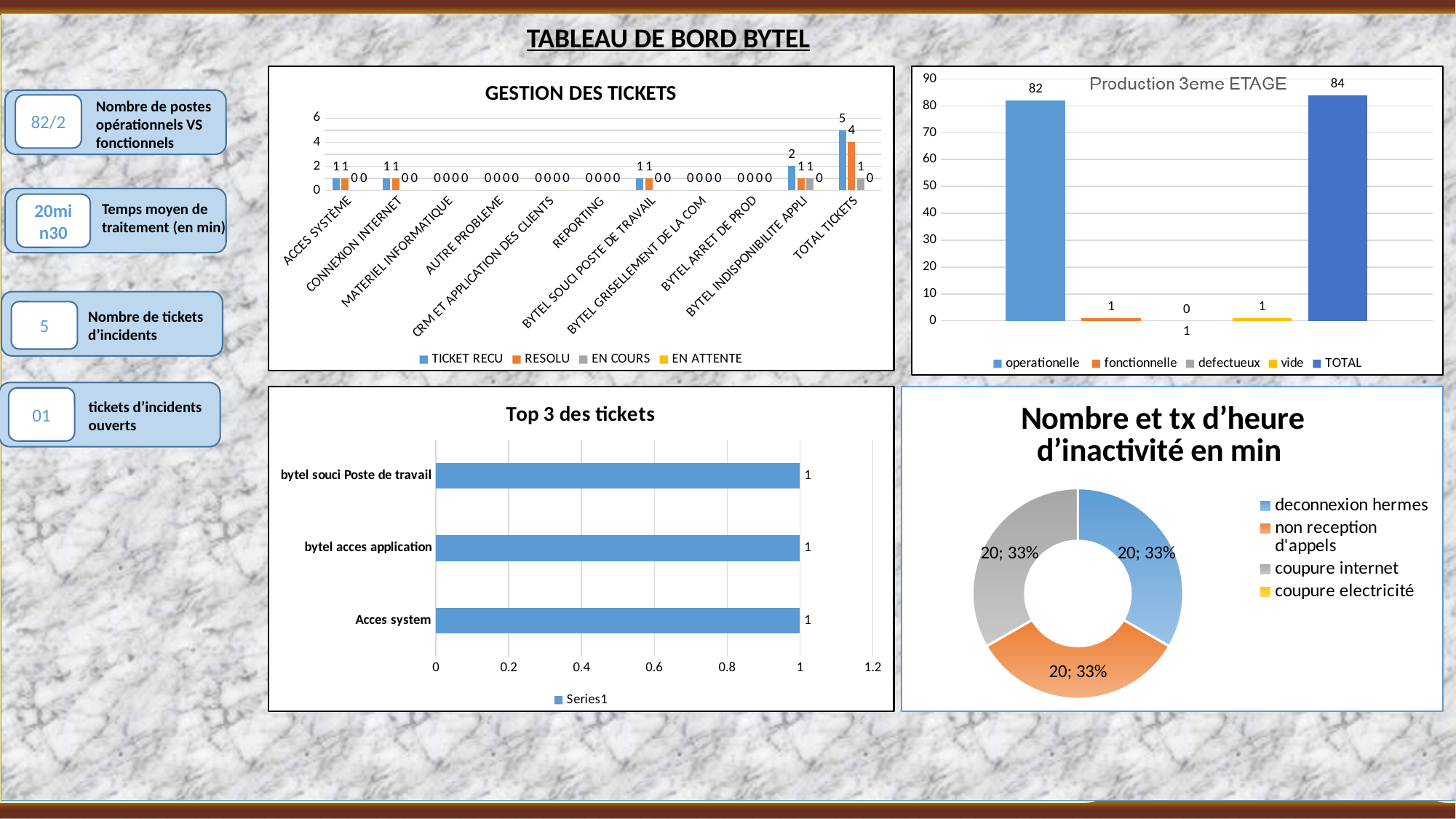
In the Production 3eme ETAGE chart, what is the value for operationelle? 82 In the Top 3 des tickets chart, what is the value for Acces system? 1 In the GESTION DES TICKETS chart, what is the TICKET RECU value for BYTEL INDISPONIBILITE APPLI? 2 In the GESTION DES TICKETS chart, how many series does the legend list? 4 In the GESTION DES TICKETS chart, what is the RESOLU value for TOTAL TICKETS? 4 In the 'Nombre et tx d'heure d'inactivité en min' chart, what share does coupure internet have? 33% What kind of chart is the 'Nombre et tx d'heure d'inactivité en min' chart? Doughnut chart In the Production 3eme ETAGE chart, what is the difference between TOTAL and operationelle? 2 In the Top 3 des tickets chart, how many categories are shown? 3 In the GESTION DES TICKETS chart, what is the TICKET RECU value for TOTAL TICKETS? 5 In the Production 3eme ETAGE chart, what is the value for TOTAL? 84 In the Production 3eme ETAGE chart, which category has the highest value? TOTAL